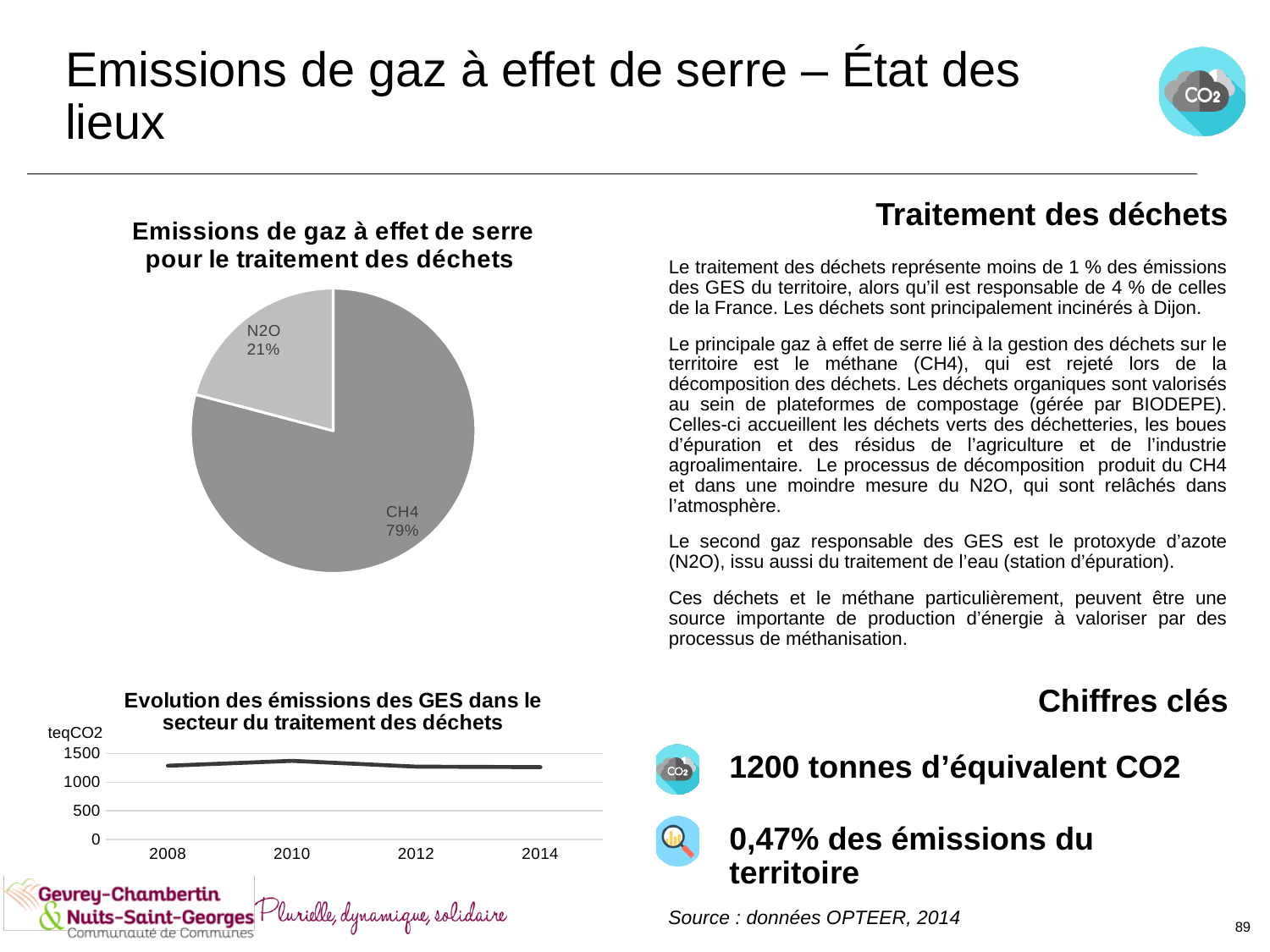
In the chart 'Evolution des émissions des GES dans le secteur du traitement des déchets', is the value for 2014 greater or less than 1500? less How many slices does the pie chart 'Emissions de gaz à effet de serre pour le traitement des déchets' have? 2 In the pie chart on the slide, which gas has the smallest share? N2O What kind of chart is the upper-left chart on the slide? Pie chart In the pie chart on the slide, which gas has the largest share? CH4 In the chart 'Evolution des émissions des GES dans le secteur du traitement des déchets', is the value for 2010 greater or less than 1000? greater What unit is shown on the y axis of the chart 'Evolution des émissions des GES dans le secteur du traitement des déchets'? teqCO2 In the pie chart on the slide, by how many percentage points does the CH4 share exceed the N2O share? 58 percentage points In the pie chart 'Emissions de gaz à effet de serre pour le traitement des déchets', what share is CH4? 79% What kind of chart is 'Evolution des émissions des GES dans le secteur du traitement des déchets'? Line chart How many years are labelled on the x axis of the chart 'Evolution des émissions des GES dans le secteur du traitement des déchets'? 4 In the pie chart 'Emissions de gaz à effet de serre pour le traitement des déchets', what share is N2O? 21%